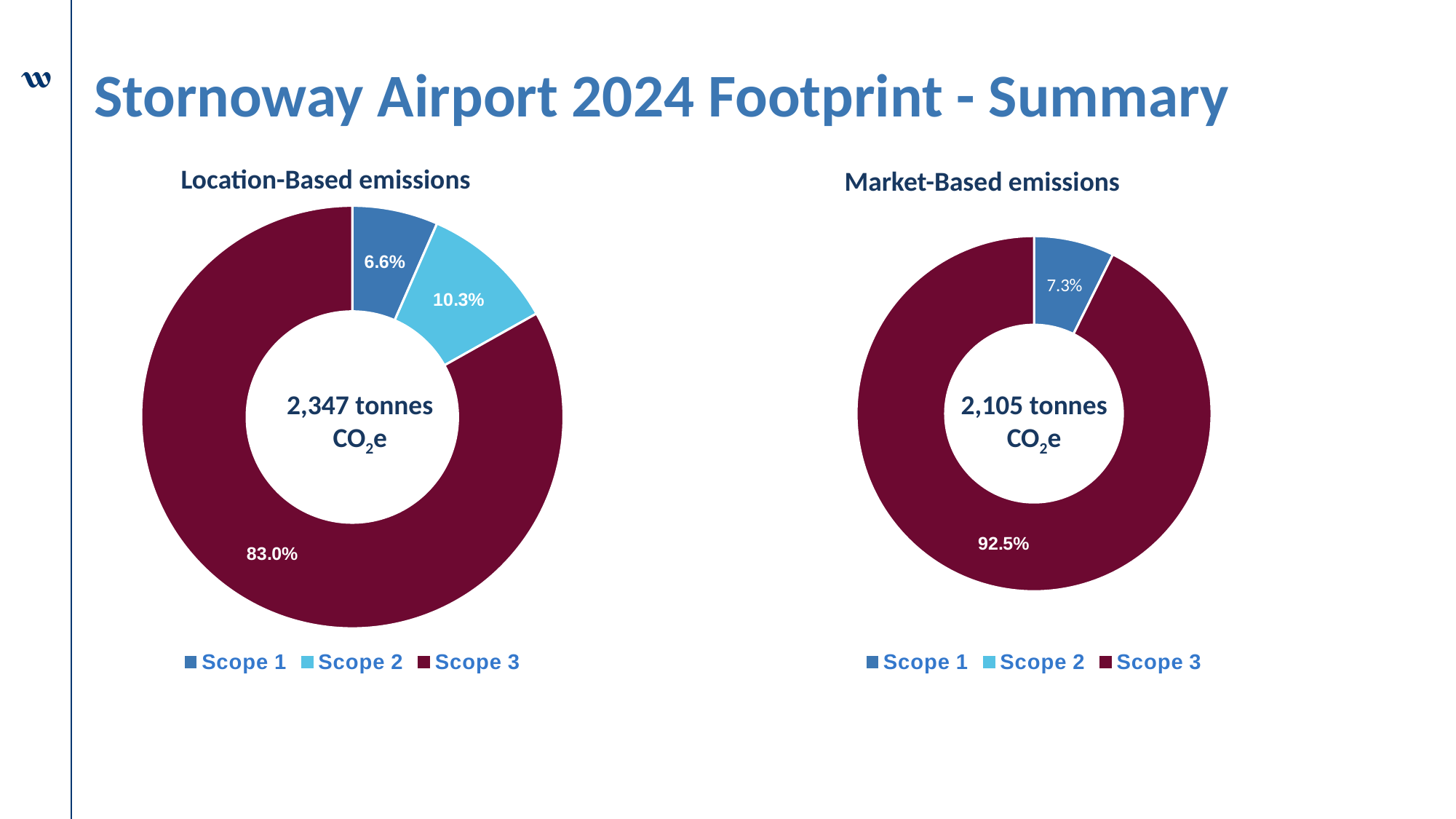
In the Location-Based emissions chart, what share of emissions is Scope 3? 83.0% In the Market-Based emissions chart, what share of emissions is Scope 3? 92.5% In the Location-Based emissions chart, what share of emissions is Scope 2? 10.3% In the Location-Based emissions chart, which scope has the largest share? Scope 3 What kind of chart is the Market-Based emissions chart? Doughnut chart What total is shown in the centre of the Location-Based emissions chart? 2,347 tonnes CO2e How many entries does the legend of the Location-Based emissions chart list? 3 In the Location-Based emissions chart, what is the difference in percentage points between the Scope 2 and Scope 1 shares? 3.7 What total is shown in the centre of the Market-Based emissions chart? 2,105 tonnes CO2e In the Location-Based emissions chart, which scope has the smallest share? Scope 1